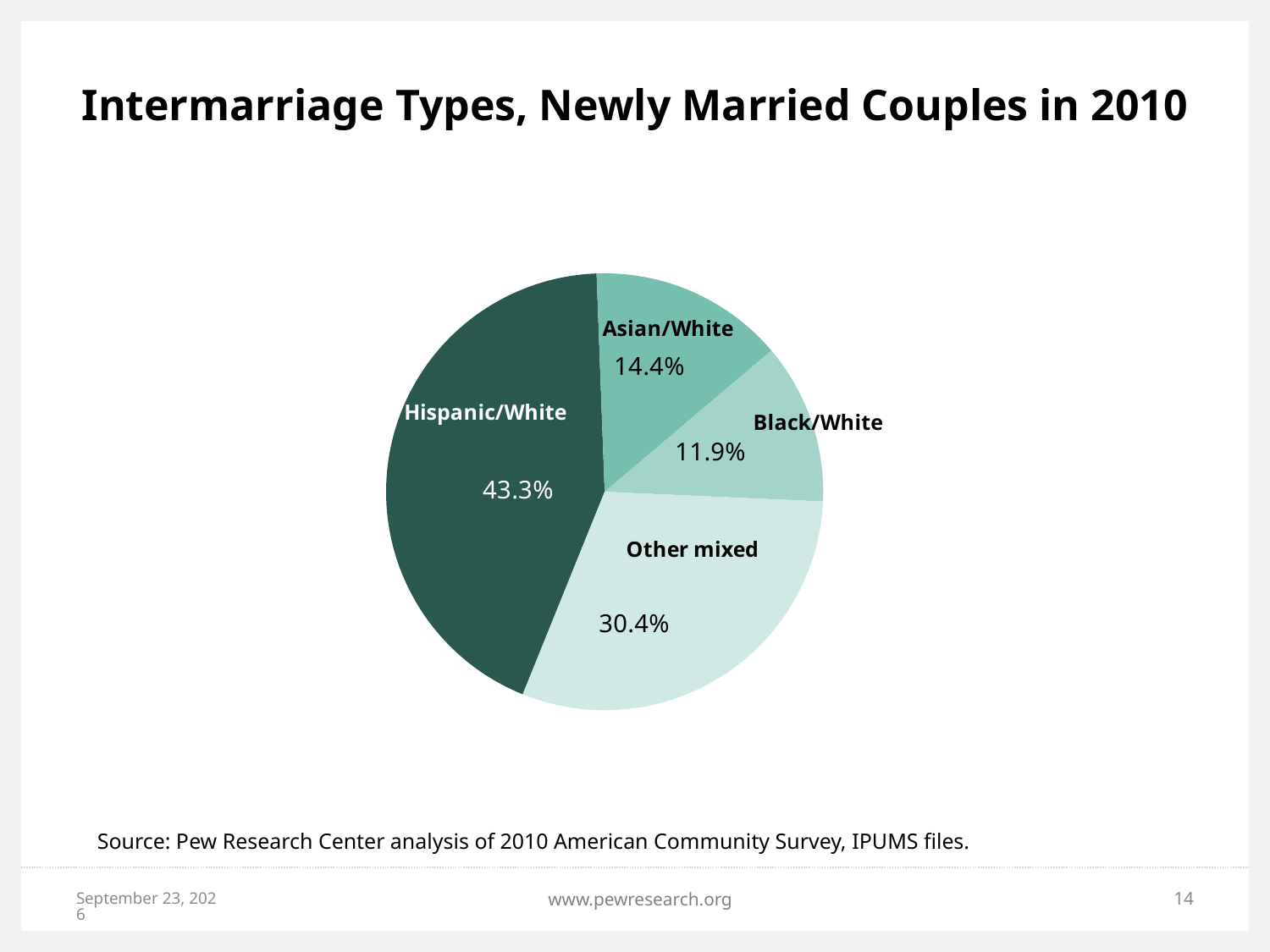
Which intermarriage type has the smallest share of the pie? Black/White What percentage does the Asian/White slice represent? 14.4% What is the difference in percentage points between Asian/White and Black/White? 2.5 Which is larger, the Asian/White share or the Black/White share? Asian/White How many percentage points larger is the Hispanic/White share than the Other mixed share? 12.9 What is the title of the chart? Intermarriage Types, Newly Married Couples in 2010 Which intermarriage type has the largest share of the pie? Hispanic/White What kind of chart is shown on the slide? Pie chart What is the value shown for Black/White? 11.9% What percentage is labelled for the Other mixed slice? 30.4% How many slices does the pie chart have? 4 What share of newly married intermarried couples in 2010 were Hispanic/White? 43.3%